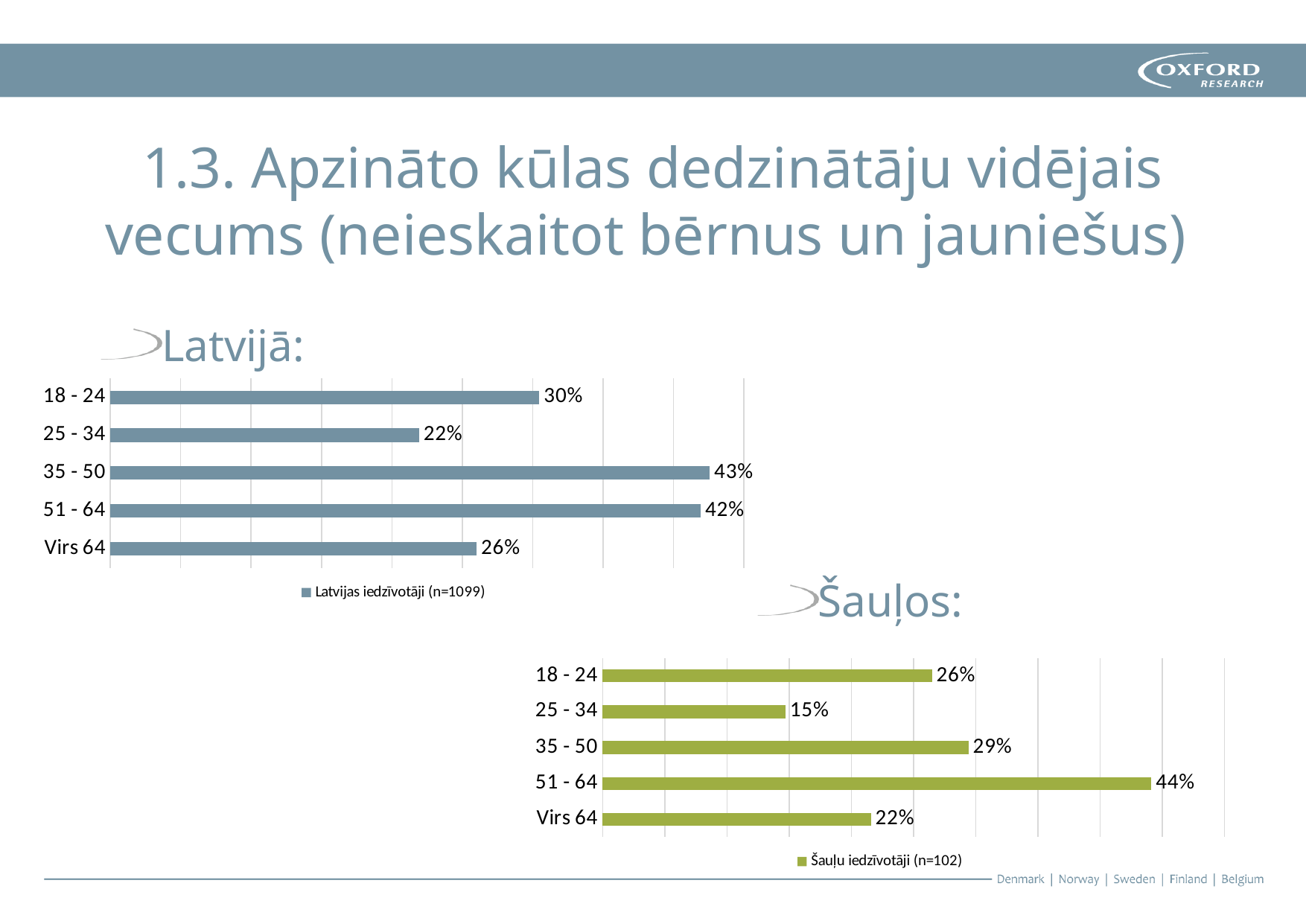
In the Šauļos chart, which age group has the lowest value? 25 - 34 How many age groups are shown in the Latvijā chart? 5 What type of chart is the Šauļos chart? Bar chart In the Latvijā chart, what is the difference between the values for 18 - 24 and Virs 64? 4% In the Šauļos chart, what is the value for the 25 - 34 age group? 15% In the Latvijā chart, which age group has the lowest value? 25 - 34 In the Šauļos chart, what is the difference between the values for 51 - 64 and 35 - 50? 15% In the Latvijā chart, what is the value for the 35 - 50 age group? 43% In the Latvijā chart, which is larger: the value for 18 - 24 or the value for Virs 64? 18 - 24 In the Šauļos chart, which age group has the highest value? 51 - 64 What is the legend entry of the Latvijā chart? Latvijas iedzīvotāji (n=1099) In the Šauļos chart, which is larger: the value for 18 - 24 or the value for 35 - 50? 35 - 50